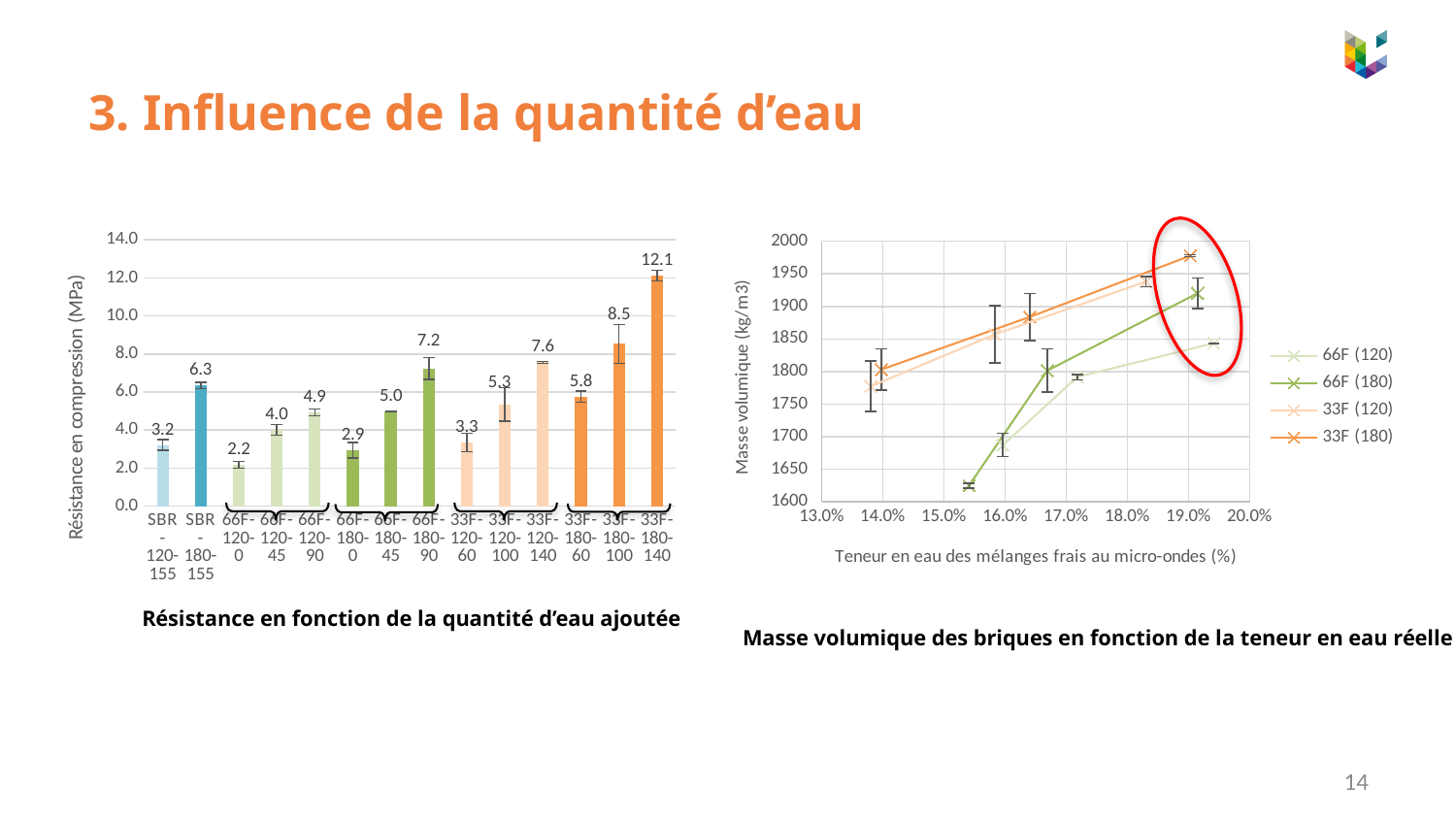
In the chart 'Résistance en fonction de la quantité d'eau ajoutée', what is the value for 66F-180-45? 5.0 What kind of chart is 'Résistance en fonction de la quantité d'eau ajoutée'? Bar chart How many bars are plotted in the chart 'Résistance en fonction de la quantité d'eau ajoutée'? 14 In the chart 'Résistance en fonction de la quantité d'eau ajoutée', which is larger: 66F-180-90 or 33F-120-140? 33F-120-140 In the chart 'Résistance en fonction de la quantité d'eau ajoutée', which category has the lowest value? 66F-120-0 What is the y-axis label of the chart 'Masse volumique des briques en fonction de la teneur en eau réelle'? Masse volumique (kg/m3) How many series does the legend list in the chart 'Masse volumique des briques en fonction de la teneur en eau réelle'? 4 In the chart 'Masse volumique des briques en fonction de la teneur en eau réelle', is the highest point of the 33F (180) series greater or less than 1950? greater In the chart 'Résistance en fonction de la quantité d'eau ajoutée', which category has the highest value? 33F-180-140 In the chart 'Résistance en fonction de la quantité d'eau ajoutée', what is the compressive strength for 33F-180-140? 12.1 In the chart 'Masse volumique des briques en fonction de la teneur en eau réelle', does the 66F (180) series rise or fall as the water content increases? rise In the chart 'Résistance en fonction de la quantité d'eau ajoutée', what is the difference between SBR-180-155 and SBR-120-155? 3.1